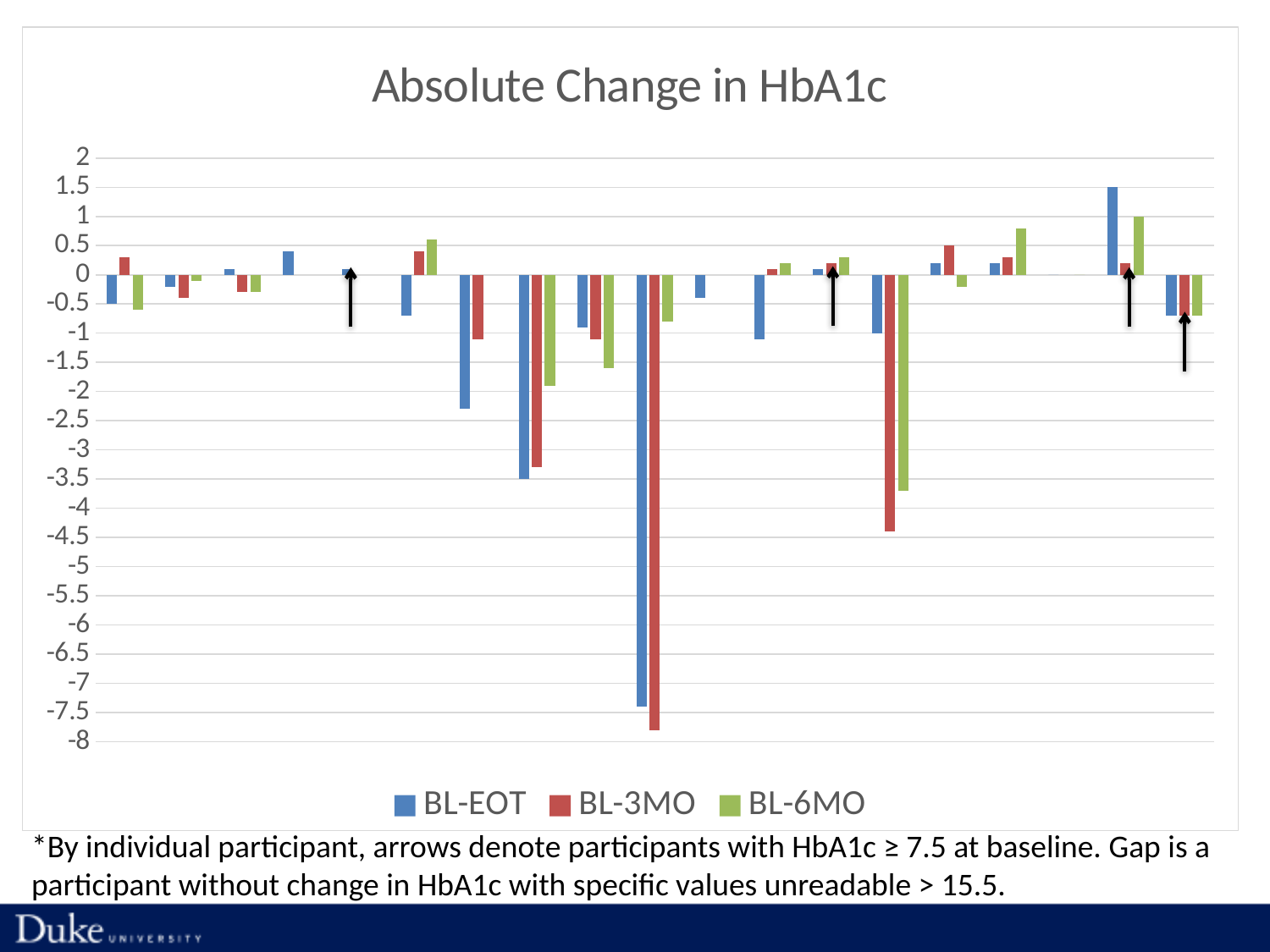
Is the highest BL-EOT bar greater or less than 1? greater Which series is shown in red in the legend? BL-3MO Which series contains the highest bar on the chart? BL-EOT Is the lowest BL-6MO bar greater or less than -4? greater What kind of chart is shown on the slide? bar chart Which series contains the lowest bar on the chart? BL-3MO What is the title of the chart? Absolute Change in HbA1c Is the lowest BL-EOT bar greater or less than -7? less How many series does the legend list? 3